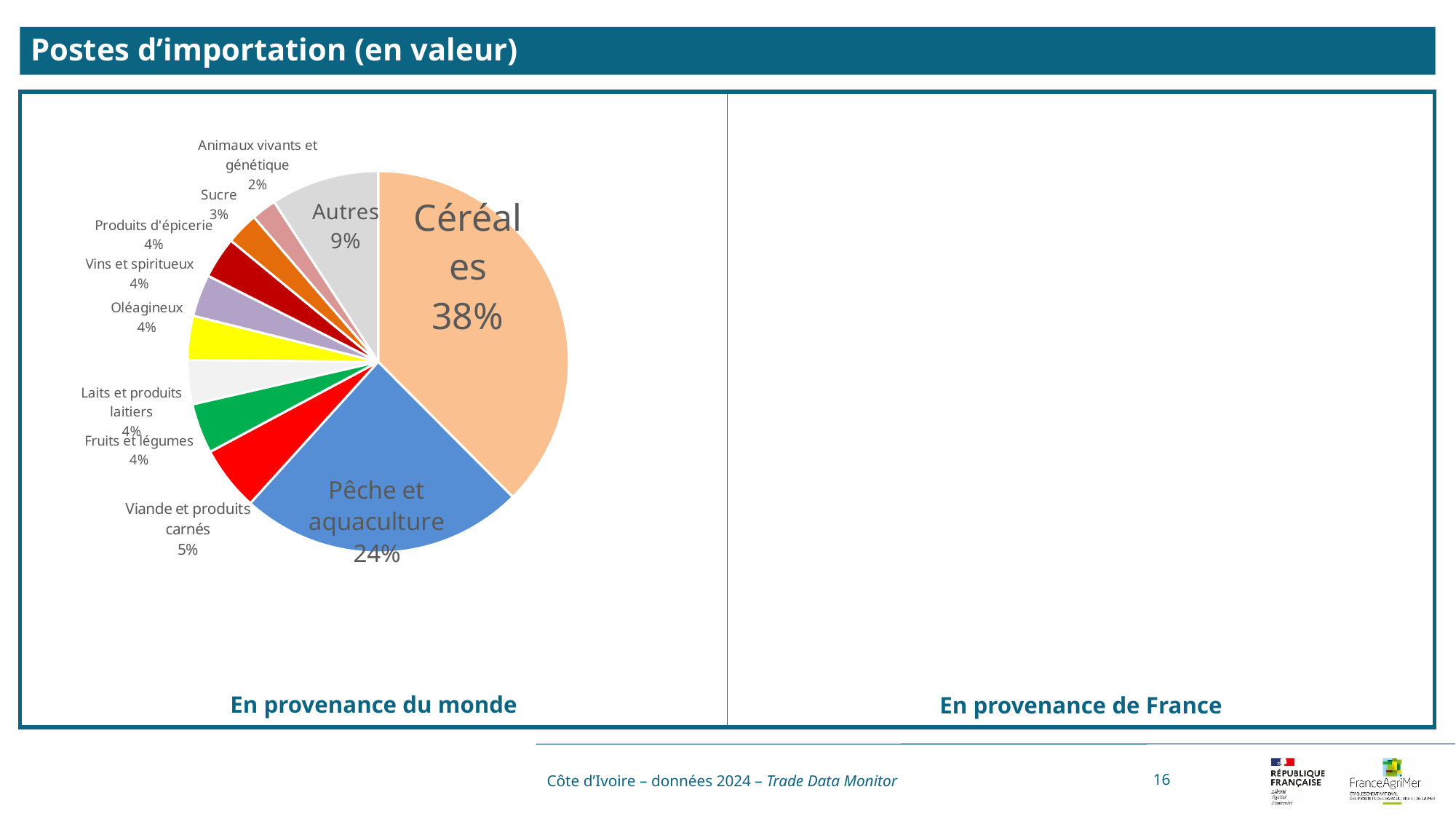
How many slices does the "En provenance du monde" pie chart have? 11 In the "En provenance du monde" pie chart, which is larger: Autres or Viande et produits carnés? Autres In the "En provenance du monde" pie chart, what share do Céréales represent? 38% In the "En provenance du monde" pie chart, how many percentage points larger is Céréales than Pêche et aquaculture? 14 Which category has the largest slice in the "En provenance du monde" pie chart? Céréales In the "En provenance du monde" pie chart, what percentage is labelled for Viande et produits carnés? 5% In the "En provenance du monde" pie chart, what is the share of Pêche et aquaculture? 24% In the "En provenance du monde" pie chart, what share is shown for Animaux vivants et génétique? 2% Which category has the smallest slice in the "En provenance du monde" pie chart? Animaux vivants et génétique In the "En provenance du monde" pie chart, what share is shown for Sucre? 3% What type of chart is shown under "En provenance du monde"? pie chart What is the title of the slide containing the pie chart? Postes d'importation (en valeur)